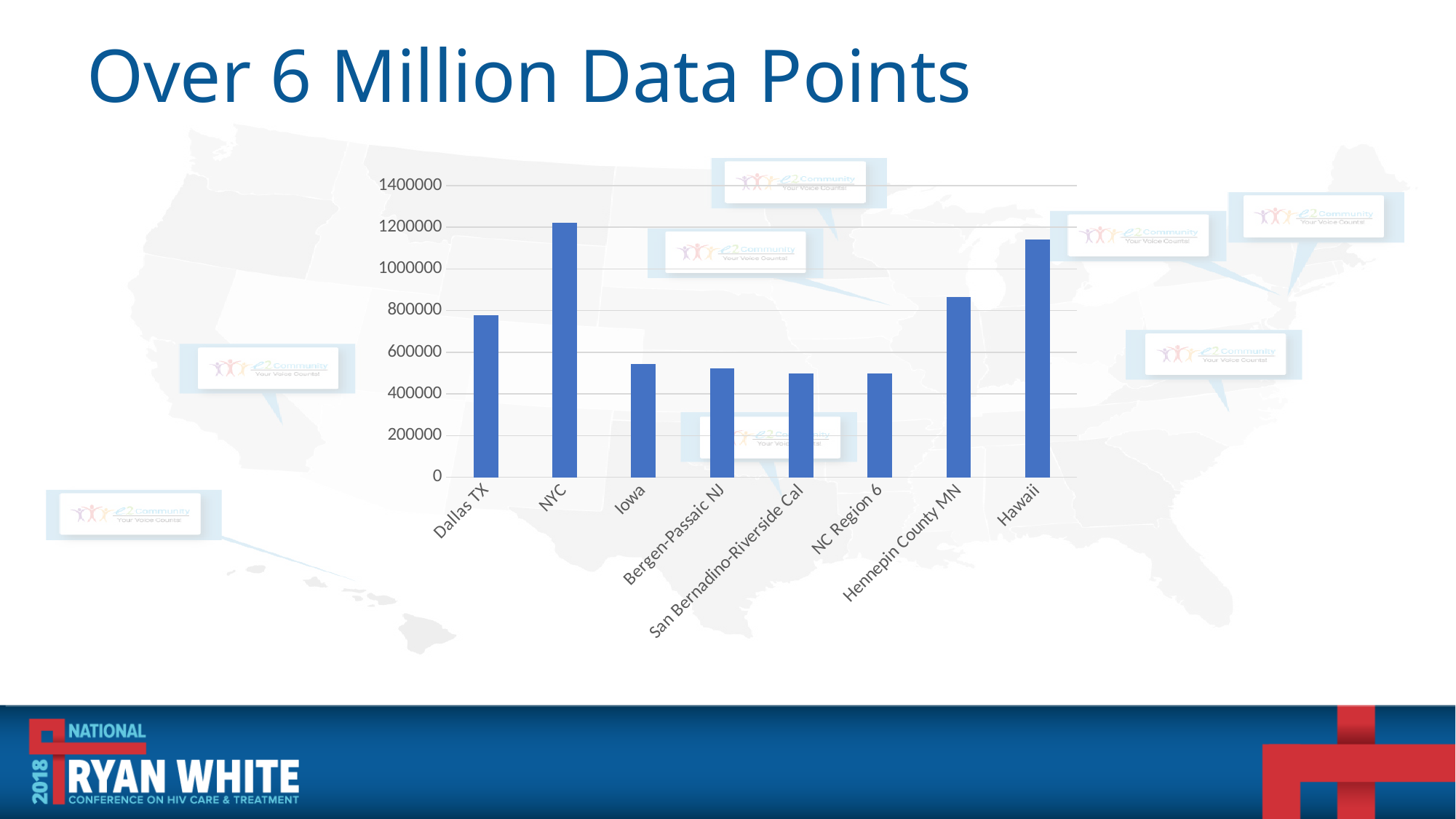
Is the value for Hawaii greater or less than 1000000? greater Is the value for Hennepin County MN greater or less than 800000? greater Is the value for NYC greater or less than 1000000? greater What is the title of the slide containing the chart? Over 6 Million Data Points What kind of chart is shown on the slide? bar chart How many categories are plotted on the chart? 8 Which has a larger value, Bergen-Passaic NJ or Hawaii? Hawaii Which has a larger value, Dallas TX or Hennepin County MN? Hennepin County MN Which category has the highest value on the chart? NYC